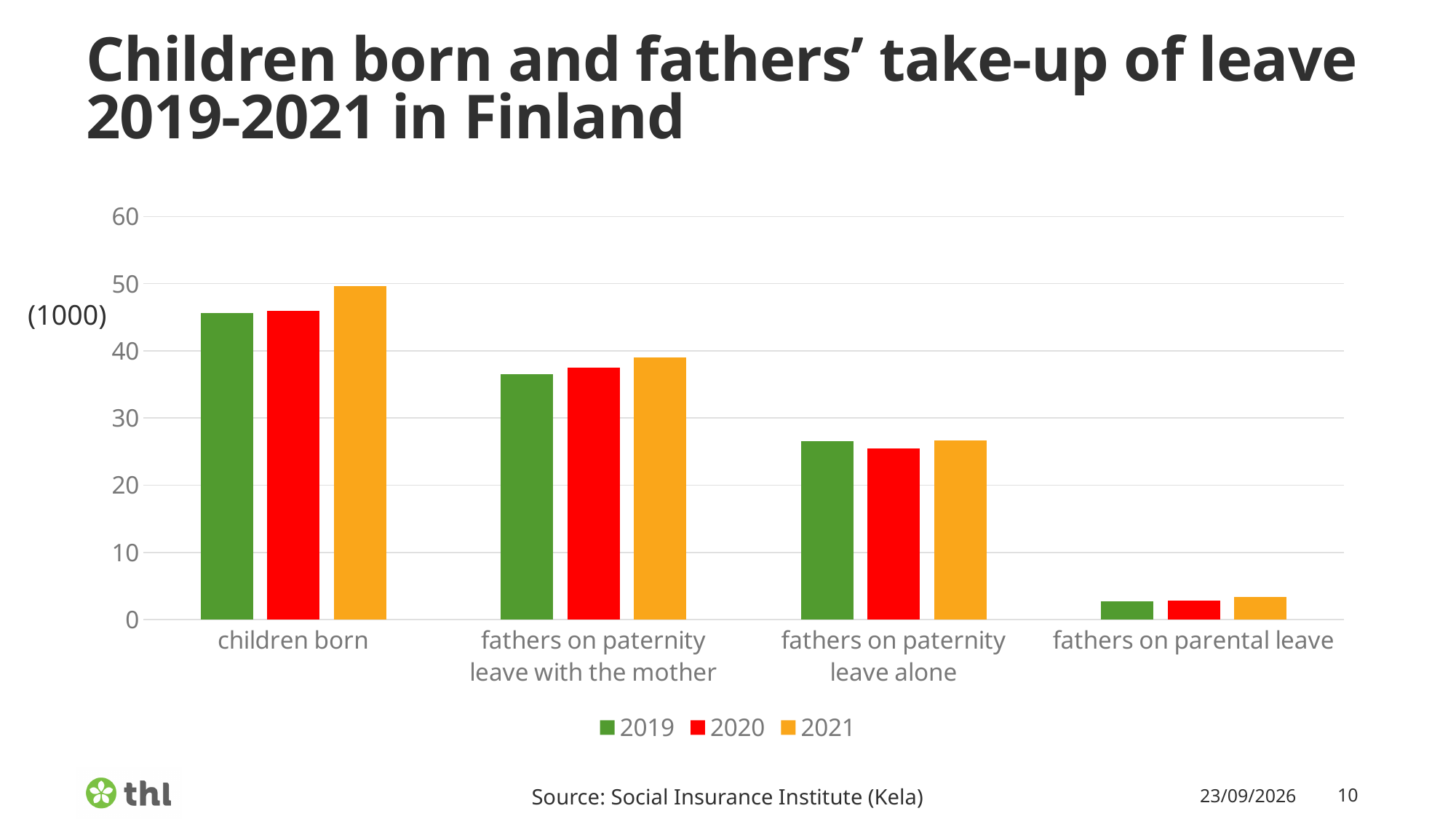
How many categories are shown on the x axis? 4 Which category has the highest values? children born Is the value for fathers on parental leave in 2019 greater or less than 10? less For children born, which year has the highest value? 2021 Is the value for fathers on paternity leave alone in 2020 greater or less than 30? less Which is larger for fathers on paternity leave with the mother: 2019 or 2021? 2021 How many series does the legend list? 3 What unit is indicated on the y axis? (1000) Is the value for children born in 2021 greater or less than 40? greater Which category has the lowest values? fathers on parental leave What kind of chart is shown on the slide? bar chart